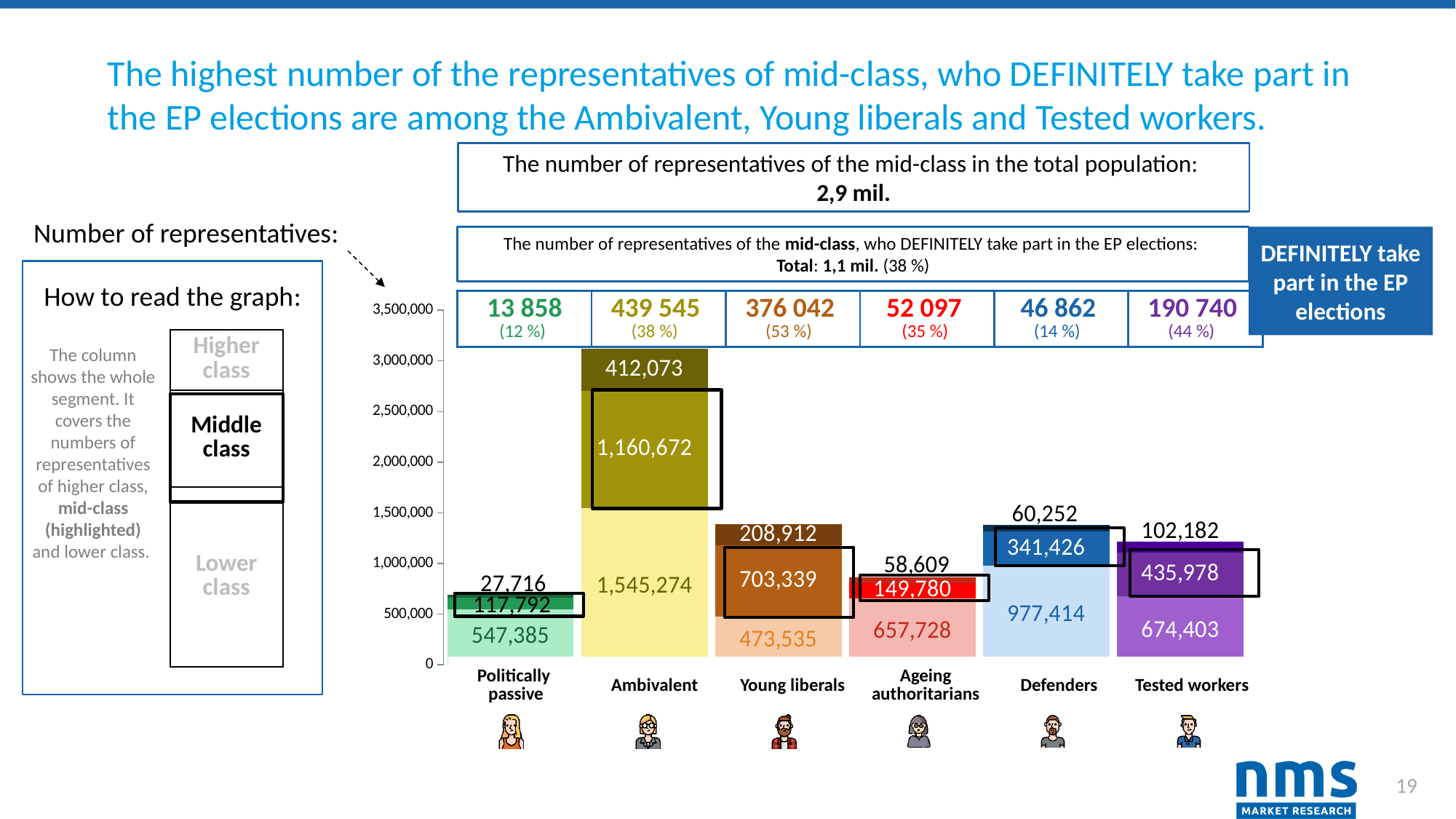
What kind of chart is shown on the slide? Stacked bar chart What is the difference between the middle-class values of Young liberals and Tested workers? 267,361 What is the higher-class value for the Tested workers segment? 102,182 What is the middle-class value for the Ambivalent segment? 1,160,672 How many segments (categories) are shown on the x axis of the chart? 6 Which segment has the highest middle-class value? Ambivalent What is the total of the stacked bar for Ambivalent? 3,118,019 Which segment has the lowest middle-class value? Politically passive What is the total of the stacked bar for Politically passive? 692,893 Which is larger, the lower-class value for Ageing authoritarians or for Tested workers? Tested workers According to the boxes above the chart, how many mid-class representatives of Young liberals DEFINITELY take part in the EP elections? 376 042 (53 %) What is the lower-class value for the Defenders segment? 977,414